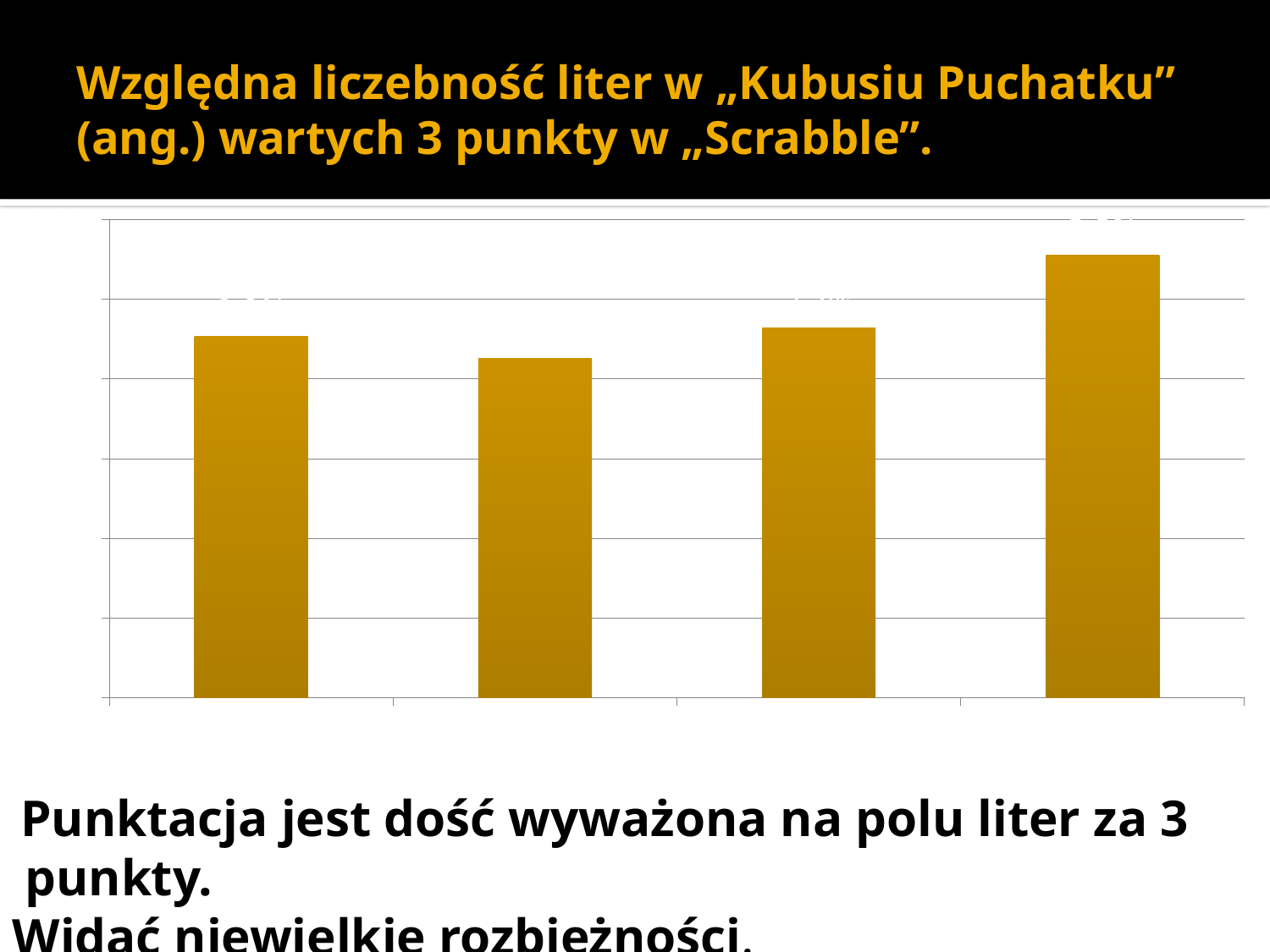
What colour are the bars in the chart? gold/orange What kind of chart is shown on the slide? bar chart Is the first bar from the left taller or shorter than the second bar? taller What is the title of the slide containing the chart? Względna liczebność liter w „Kubusiu Puchatku” (ang.) wartych 3 punkty w „Scrabble”. Which bar, counted from the left, is the tallest? the fourth How many bars does the chart show? 4 Which bar, counted from the left, is the shortest? the second Is the third bar from the left taller or shorter than the fourth bar? shorter